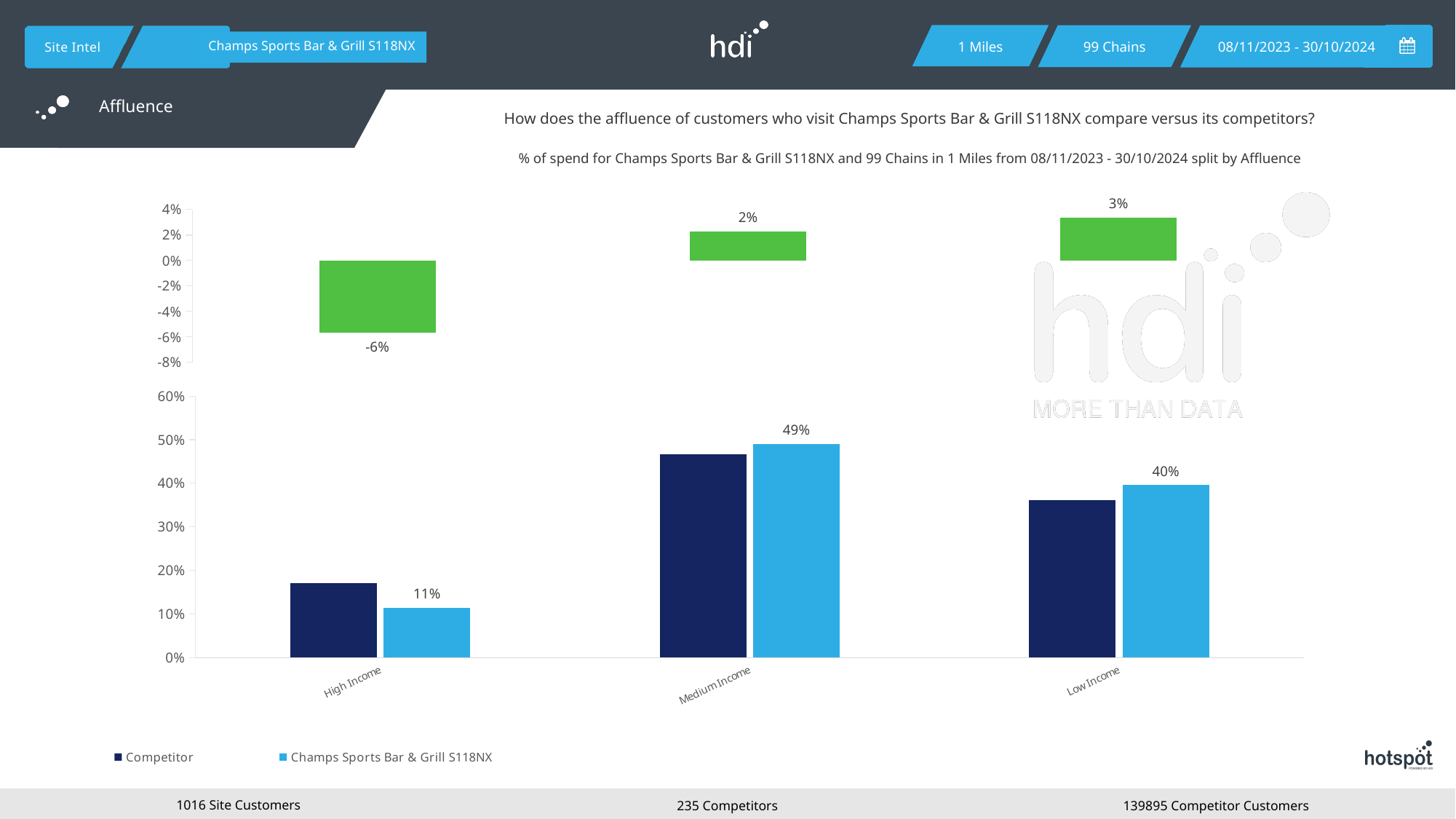
How many series does the legend of the bottom chart list? 2 In the bottom chart, which category has the highest value for Champs Sports Bar & Grill S118NX? Medium Income In the bottom chart, for High Income, which is larger: the Competitor value or the Champs Sports Bar & Grill S118NX value? Competitor In the bottom chart, is the Competitor value for Medium Income greater or less than 40%? greater In the bottom chart, what is the value for Champs Sports Bar & Grill S118NX in the High Income category? 11% In the top chart, what is the value shown for High Income? -6% In the top chart, which category has the lowest value? High Income In the bottom chart, what is the value for Champs Sports Bar & Grill S118NX in the Medium Income category? 49% How many categories are shown on the x axis of the bottom chart? 3 In the bottom chart, is the Competitor value for High Income greater or less than 20%? less In the top chart, what is the value shown for Low Income? 3% In the bottom chart, what is the difference between the Champs Sports Bar & Grill S118NX values for Medium Income and Low Income? 9%